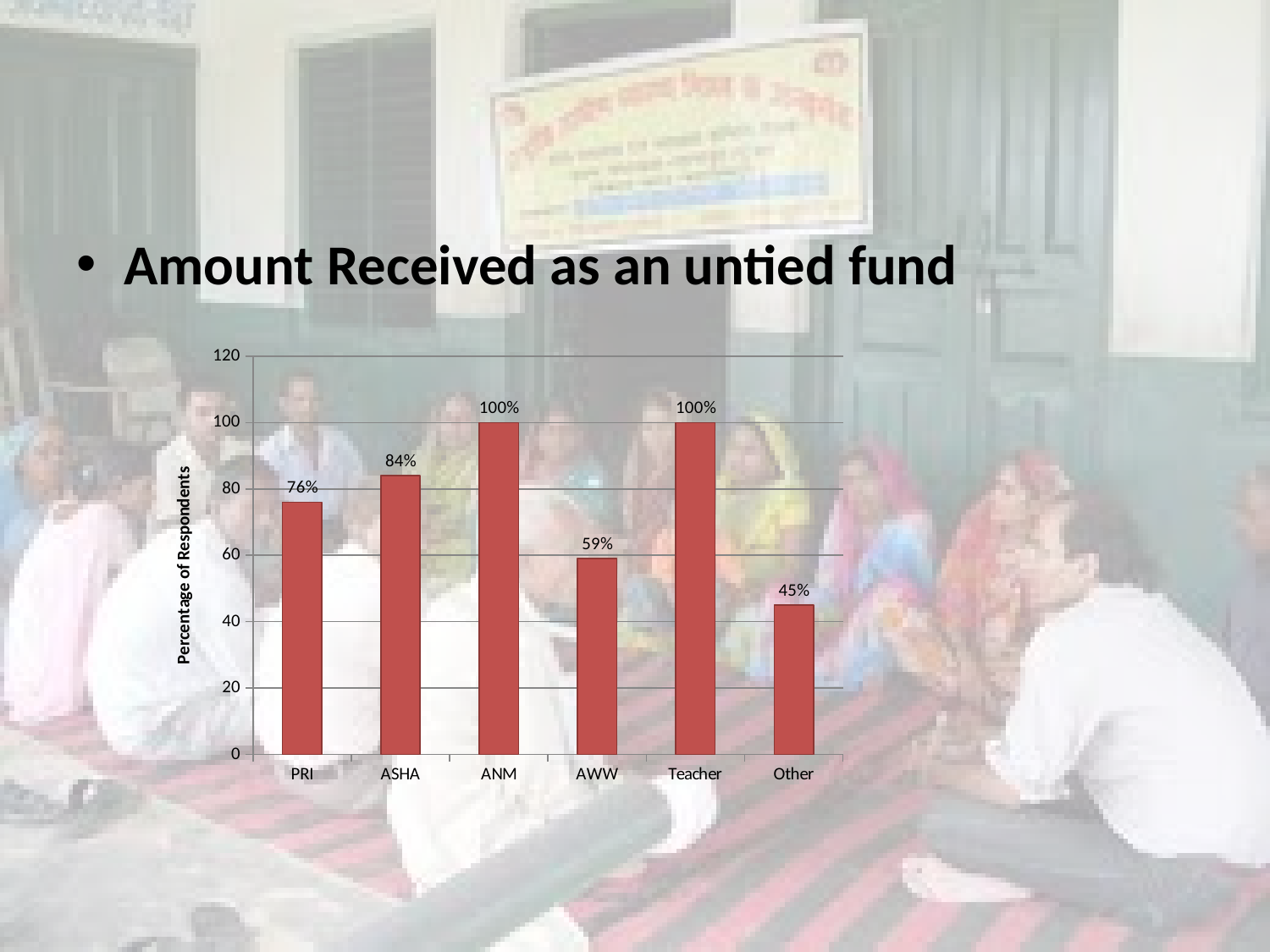
What is the label of the vertical axis? Percentage of Respondents What is the value for PRI? 76% What kind of chart is shown on the slide? Bar chart How many categories are shown on the x axis? 6 Which category has the lowest value? Other What is the difference between the values for AWW and Other? 14% What is the value for Other? 45% Which is larger, the value for ASHA or the value for AWW? ASHA What is the value for ASHA? 84% Which two categories share the highest value of 100%? ANM and Teacher What is the difference between the values for ASHA and PRI? 8% What is the value for AWW? 59%